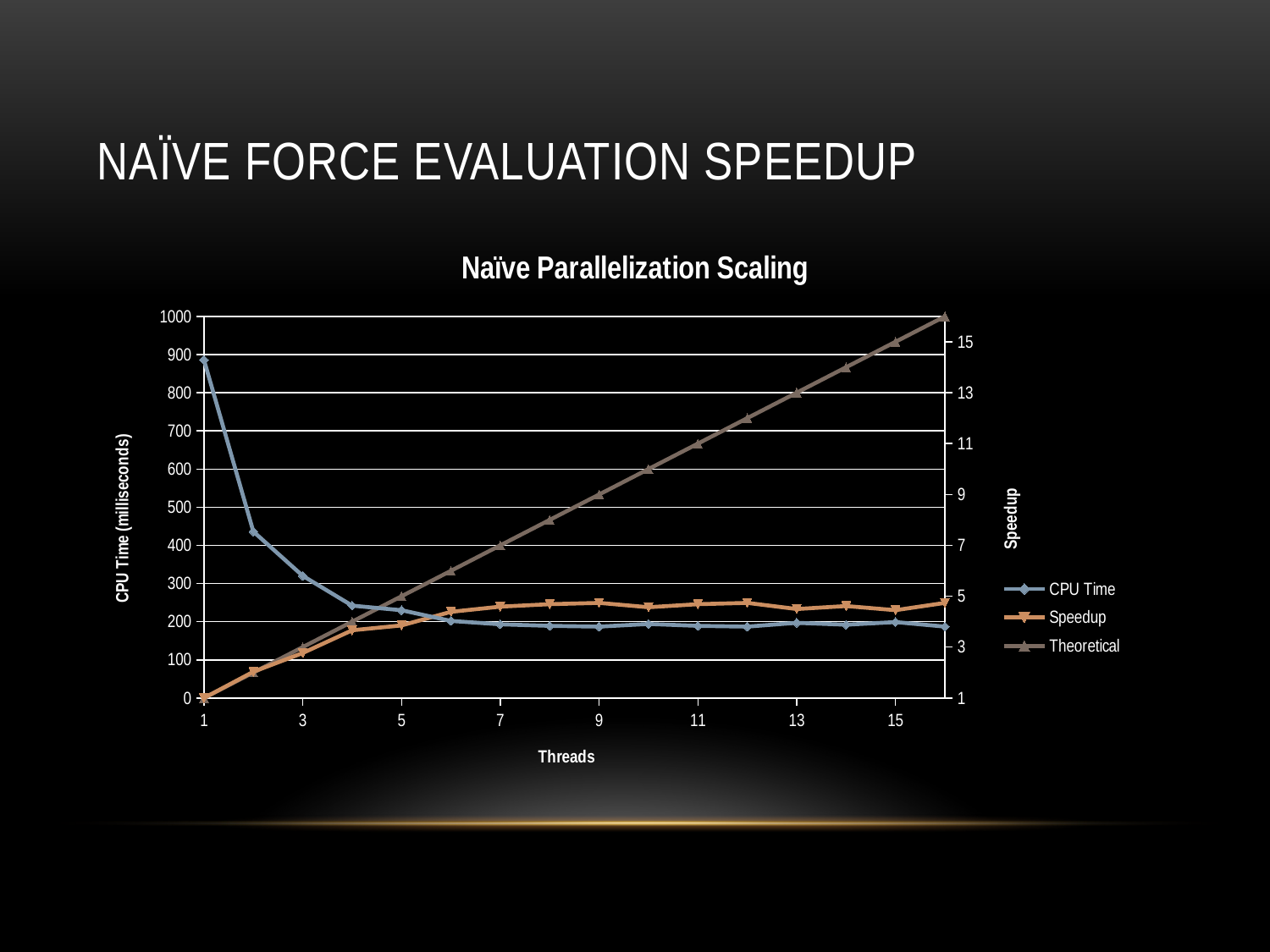
What is the Theoretical speedup at 13 threads? 13 At how many threads is the CPU Time highest? 1 Is the CPU Time at 1 thread greater or less than 800? greater What kind of chart is shown on the slide? line chart At 16 threads, which is larger: the Theoretical speedup or the measured Speedup? Theoretical What is the title of the chart? Naïve Parallelization Scaling How many series does the chart legend list? 3 What is the label of the x axis? Threads Does the CPU Time series rise or fall as the number of threads increases? fall Does the Theoretical series rise or fall as the number of threads increases? rise At how many threads is the Theoretical speedup highest? 16